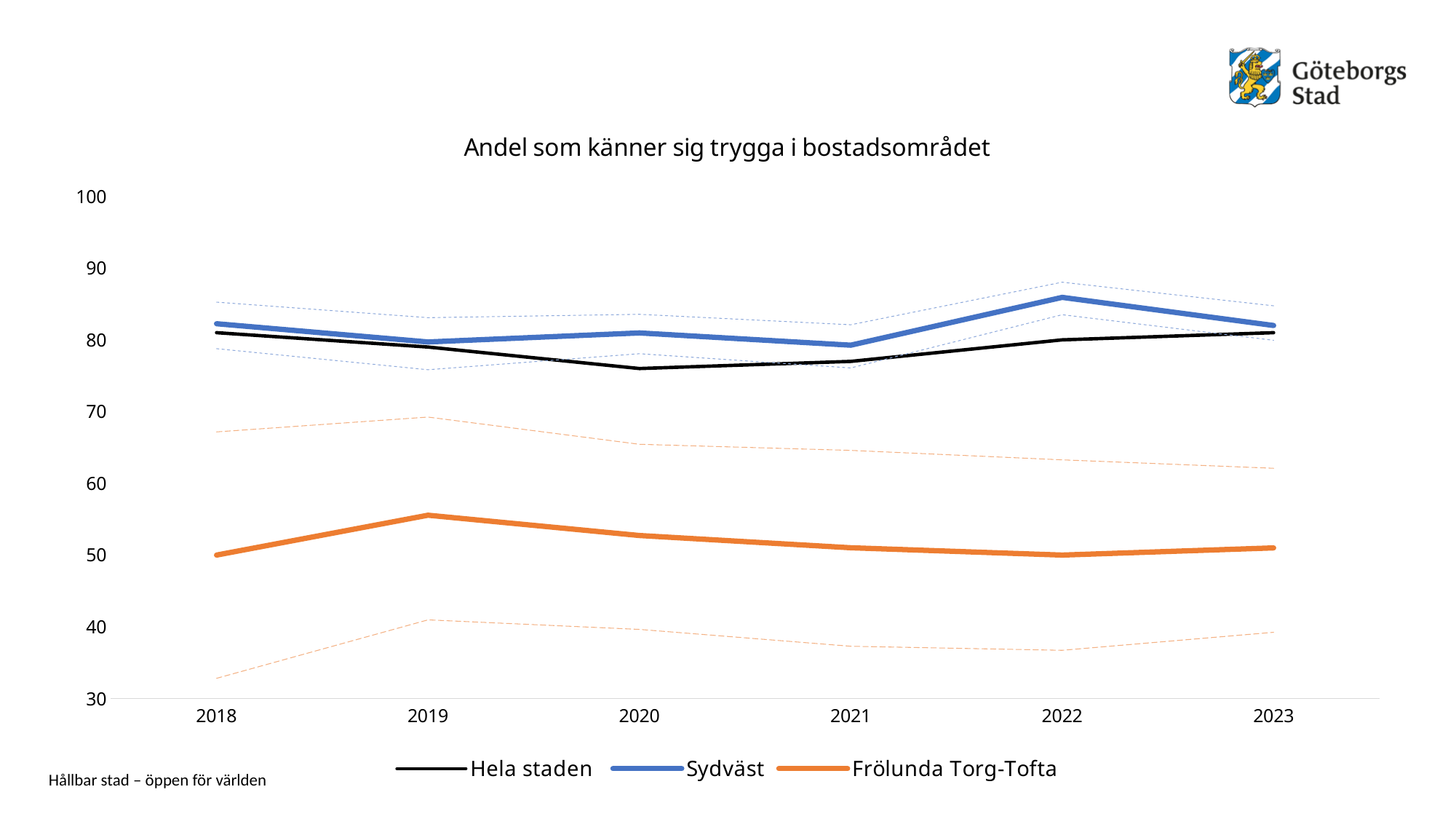
Is the value for Hela staden in 2020 greater or less than 80? less What kind of chart is shown on the slide? line chart Is the value for Sydväst in 2022 greater or less than 80? greater In which year does the Frölunda Torg-Tofta line reach its highest value? 2019 How many years are shown on the x axis? 6 In 2022, which is larger: the value for Sydväst or the value for Frölunda Torg-Tofta? Sydväst Is the value for Frölunda Torg-Tofta in 2019 greater or less than 60? less Which series has the lowest values across all years? Frölunda Torg-Tofta Does the Frölunda Torg-Tofta line rise or fall from 2018 to 2019? rise In which year does the Sydväst line reach its highest value? 2022 How many series does the legend list? 3 What is the title of the chart? Andel som känner sig trygga i bostadsområdet